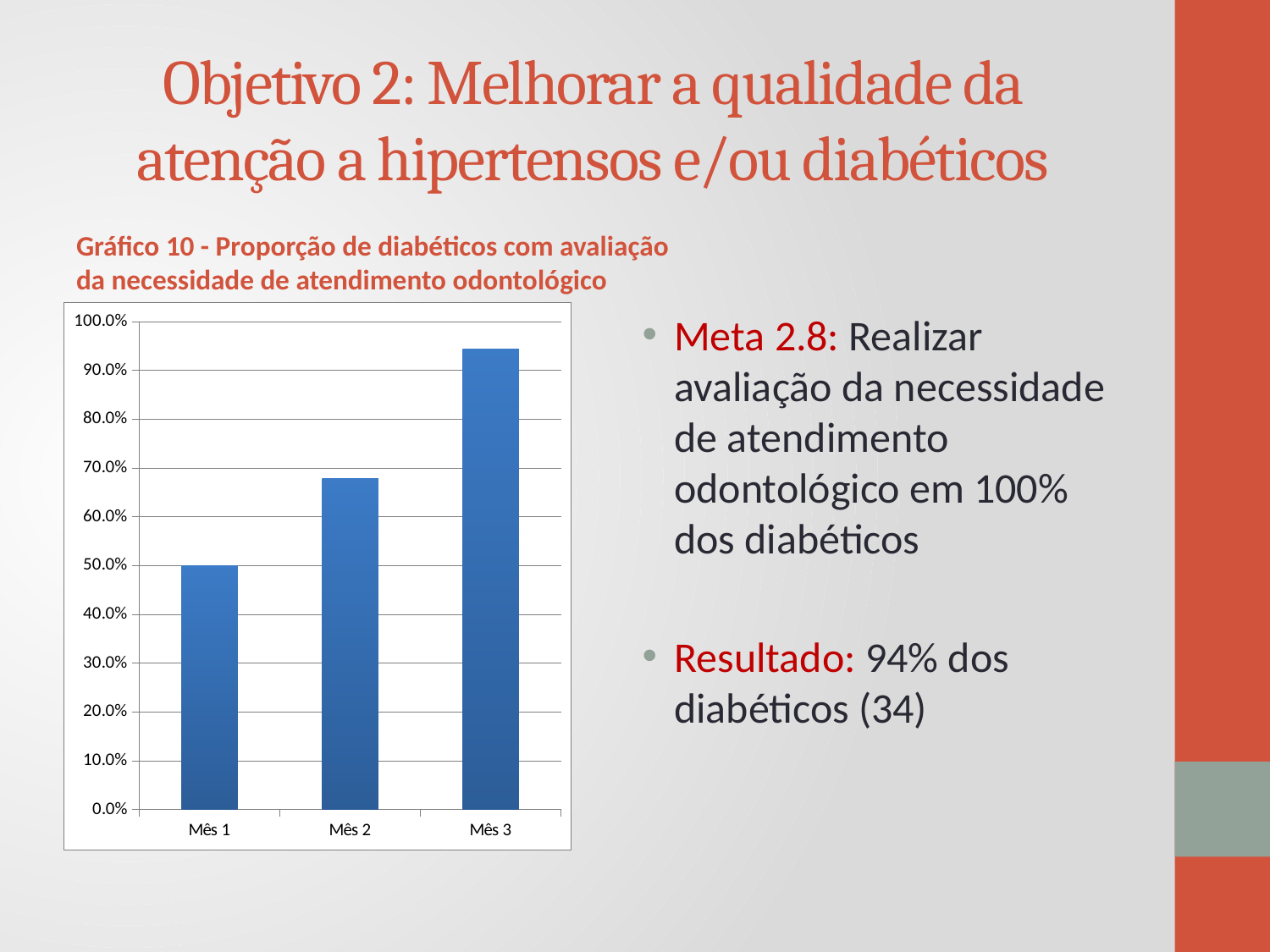
Which month has the highest proportion of diabetics with dental care needs assessed? Mês 3 Which month has the lowest value on the chart? Mês 1 Is the value for Mês 2 greater or less than 60.0%? greater Do the values rise or fall from Mês 1 to Mês 3? Rise Which is larger, the value for Mês 2 or the value for Mês 3? Mês 3 What kind of chart is shown on the slide? Bar chart How many categories (months) are plotted on the chart? 3 What is the title of the chart on the slide? Gráfico 10 - Proporção de diabéticos com avaliação da necessidade de atendimento odontológico What is the value for Mês 1 on the chart? 50.0% Is the value for Mês 3 greater or less than 90.0%? greater Is the value for Mês 2 greater or less than 70.0%? less